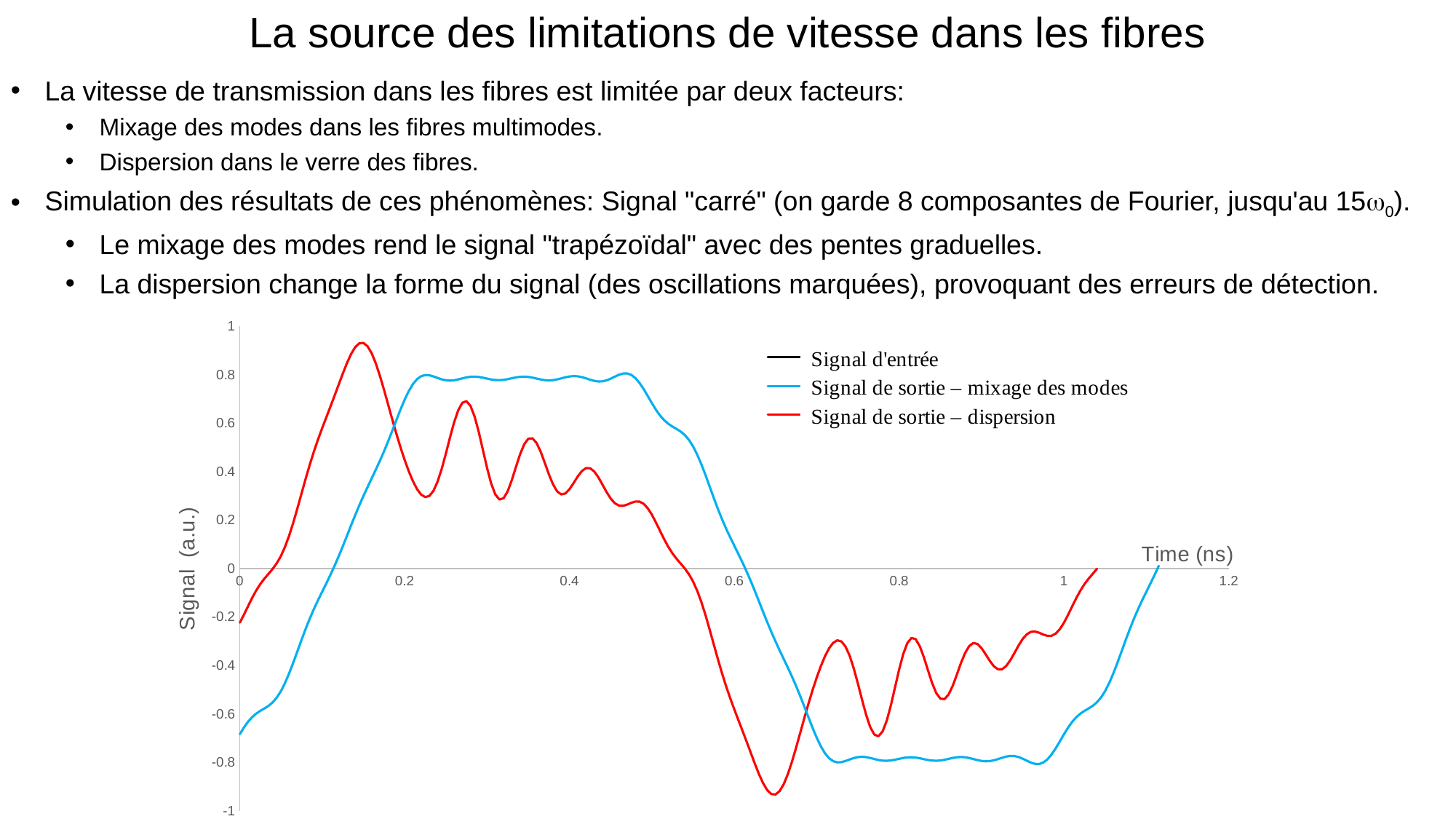
Is the value of the 'Signal de sortie – mixage des modes' series at 0.8 ns greater or less than -0.6? less What is the label of the y axis of the chart? Signal (a.u.) Is the minimum value of the 'Signal de sortie – dispersion' series near 0.65 ns greater or less than -0.8? less What kind of chart is shown on the slide? line chart Which series reaches the highest peak value on the chart? Signal de sortie – dispersion Does the 'Signal de sortie – mixage des modes' series rise or fall between 0 and 0.2 ns? rise Is the peak value of the 'Signal de sortie – dispersion' series near 0.15 ns greater or less than 0.8? greater What is the label of the x axis of the chart? Time (ns) Which series reaches the lowest value on the chart? Signal de sortie – dispersion At 0.15 ns, which series has the larger value: 'Signal de sortie – dispersion' or 'Signal de sortie – mixage des modes'? Signal de sortie – dispersion How many series does the chart legend list? 3